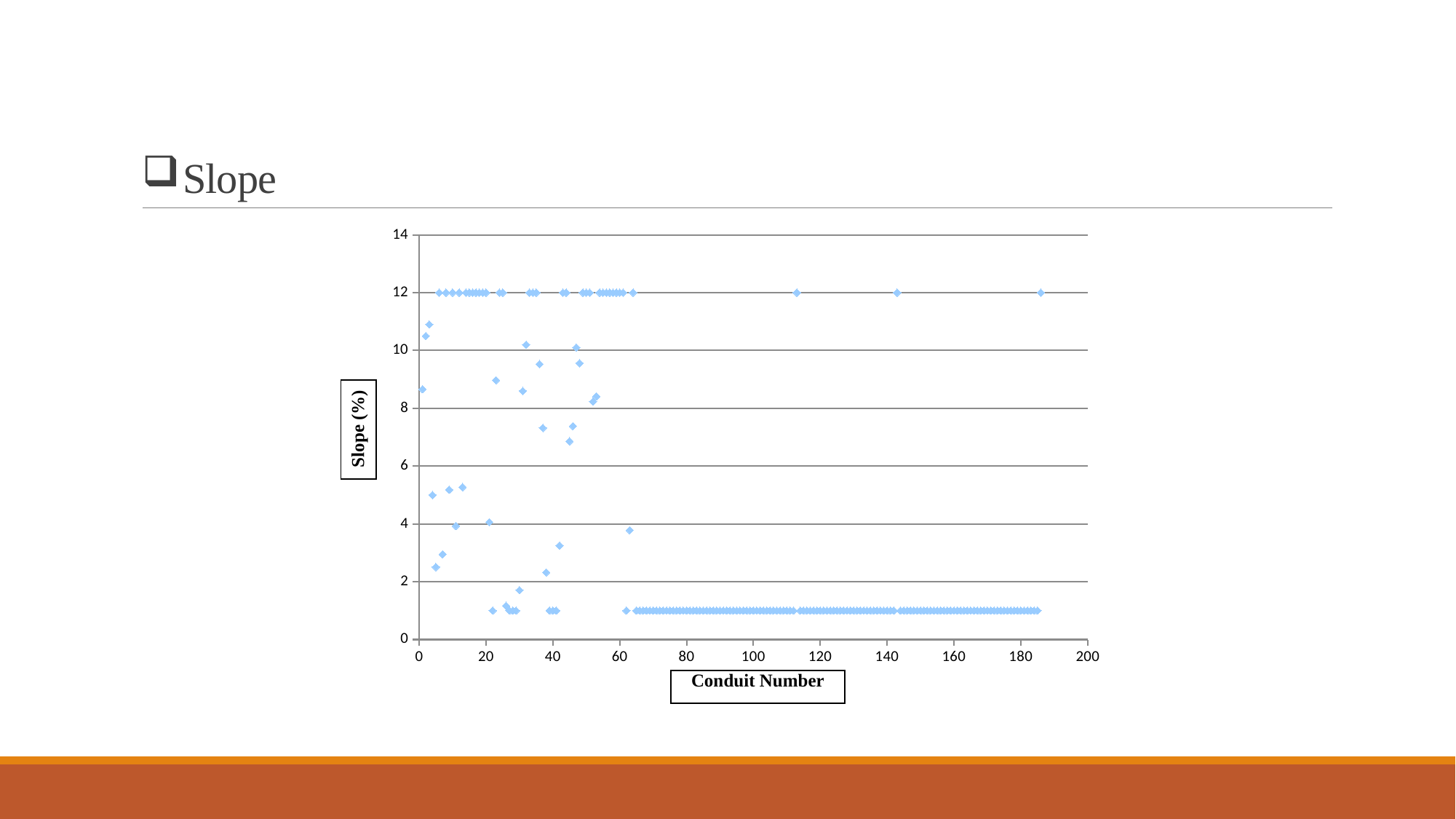
What kind of chart is shown on the slide? scatter chart What is the highest slope value plotted on the chart? 12 Between conduit numbers 65 and 110, do the plotted slope values rise, fall, or stay flat? stay flat Is the slope value for conduit number 100 greater or less than 2? less Is the slope value for conduit number 80 greater or less than 4? less What is the label of the vertical axis of the chart? Slope (%) Is the slope value for conduit number 160 greater or less than 2? less What is the label of the horizontal axis of the chart? Conduit Number